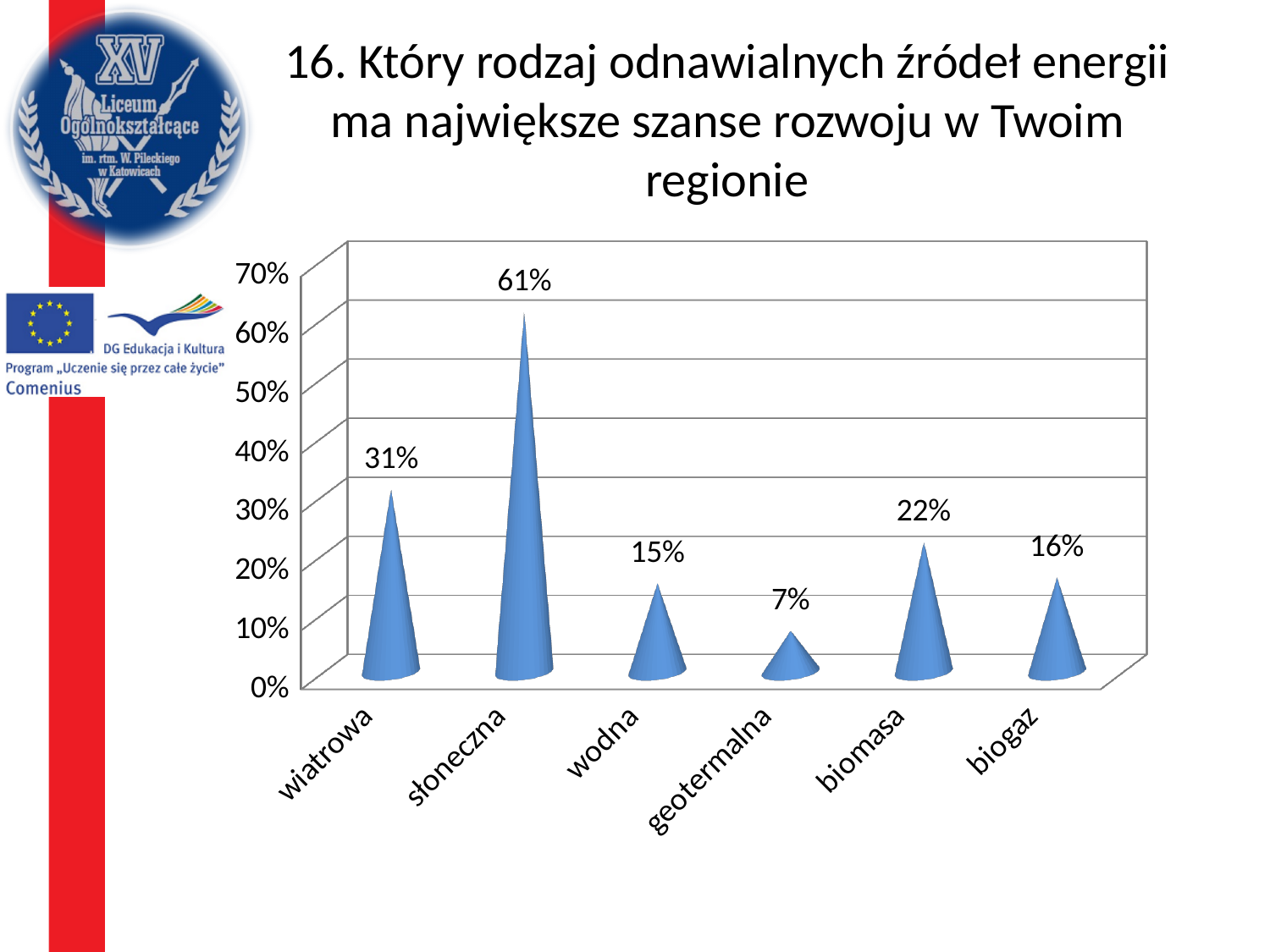
Is the value for wiatrowa greater or less than 40%? less What is the value for słoneczna? 61% What kind of chart is shown on the slide? bar chart How many categories are shown on the x axis? 6 Which is larger, the value for wodna or the value for biogaz? biogaz What is the difference between the values for biomasa and biogaz? 6% What is the difference between the values for słoneczna and wiatrowa? 30% What is the value for biomasa? 22% Which category has the lowest value? geotermalna Which category has the highest value? słoneczna What is the value for geotermalna? 7% What is the value for wiatrowa? 31%